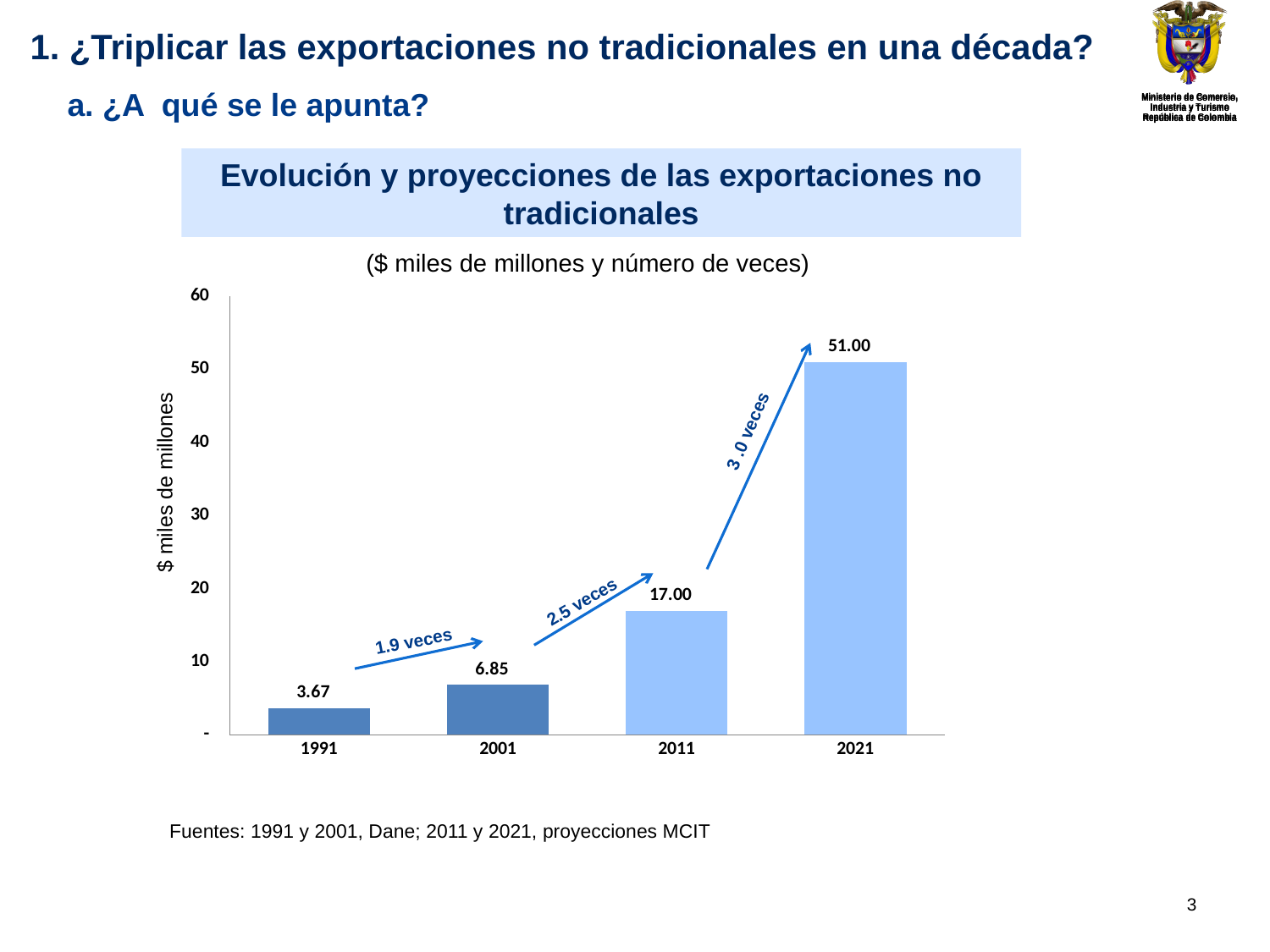
Which is larger, the value for 2001 or the value for 2011? 2011 What is the value for 1991? 3.67 Do the values rise or fall from 1991 to 2021? Rise How many years are shown on the x axis? 4 What is the value for 2001? 6.85 What is the value for 2011? 17.00 Which year has the lowest value? 1991 What kind of chart is shown? Bar chart Which year has the highest value? 2021 What is the difference between the values for 2021 and 2011? 34.00 Is the value for 2021 greater or less than 50? greater What is the value for 2021? 51.00